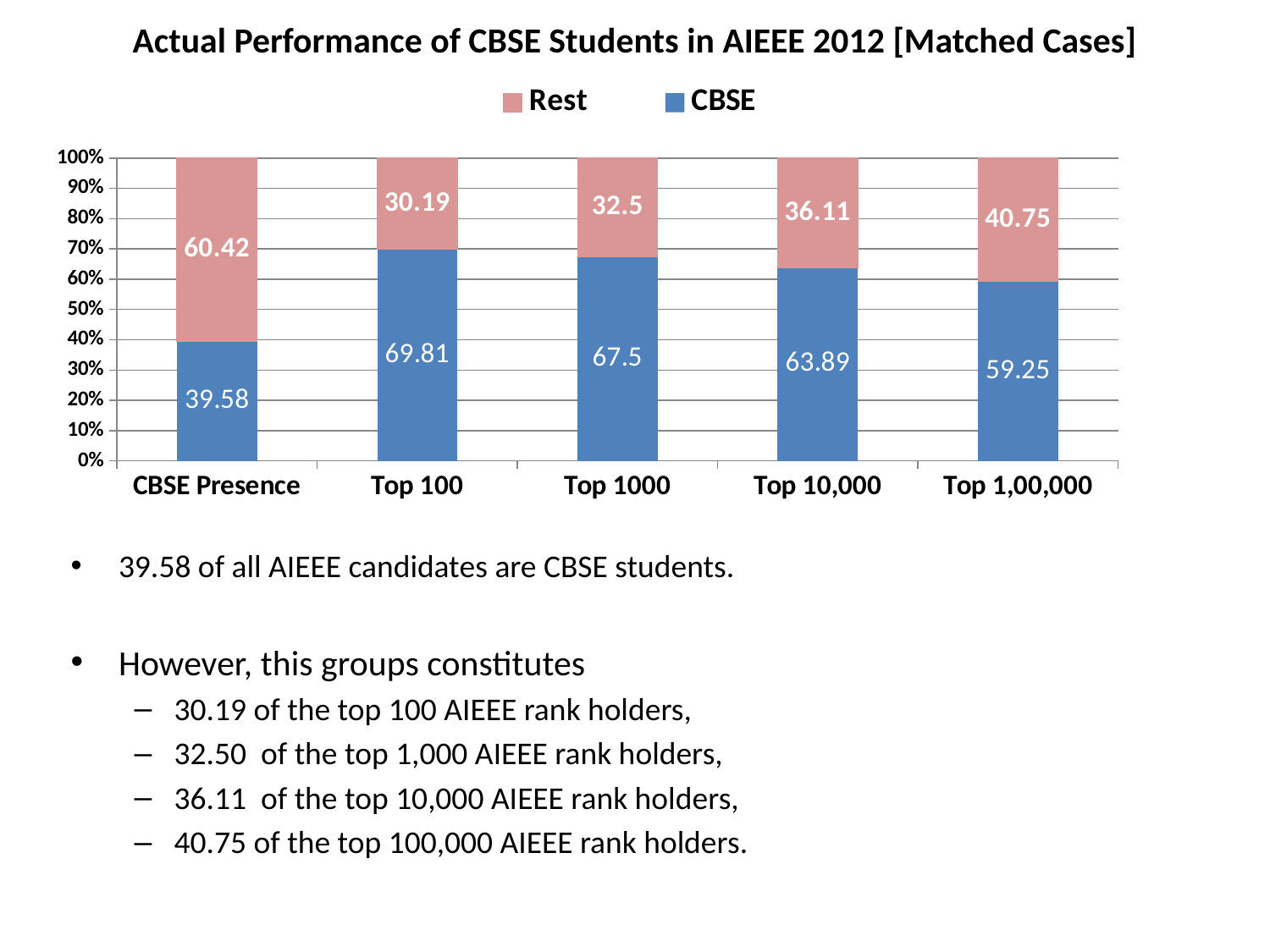
How many series does the legend list? 2 What is the CBSE value for Top 100? 69.81 How many categories are shown on the x axis? 5 What is the title of the chart? Actual Performance of CBSE Students in AIEEE 2012 [Matched Cases] Is the CBSE value for Top 1000 larger than the CBSE value for Top 10,000? Yes Which category has the highest CBSE value? Top 100 What is the difference between the CBSE values for Top 100 and Top 1000? 2.31 What is the Rest value for CBSE Presence? 60.42 What is the Rest value for Top 10,000? 36.11 Which category has the lowest CBSE value? CBSE Presence What is the CBSE value for Top 1,00,000? 59.25 What kind of chart is shown on the slide? Stacked bar chart